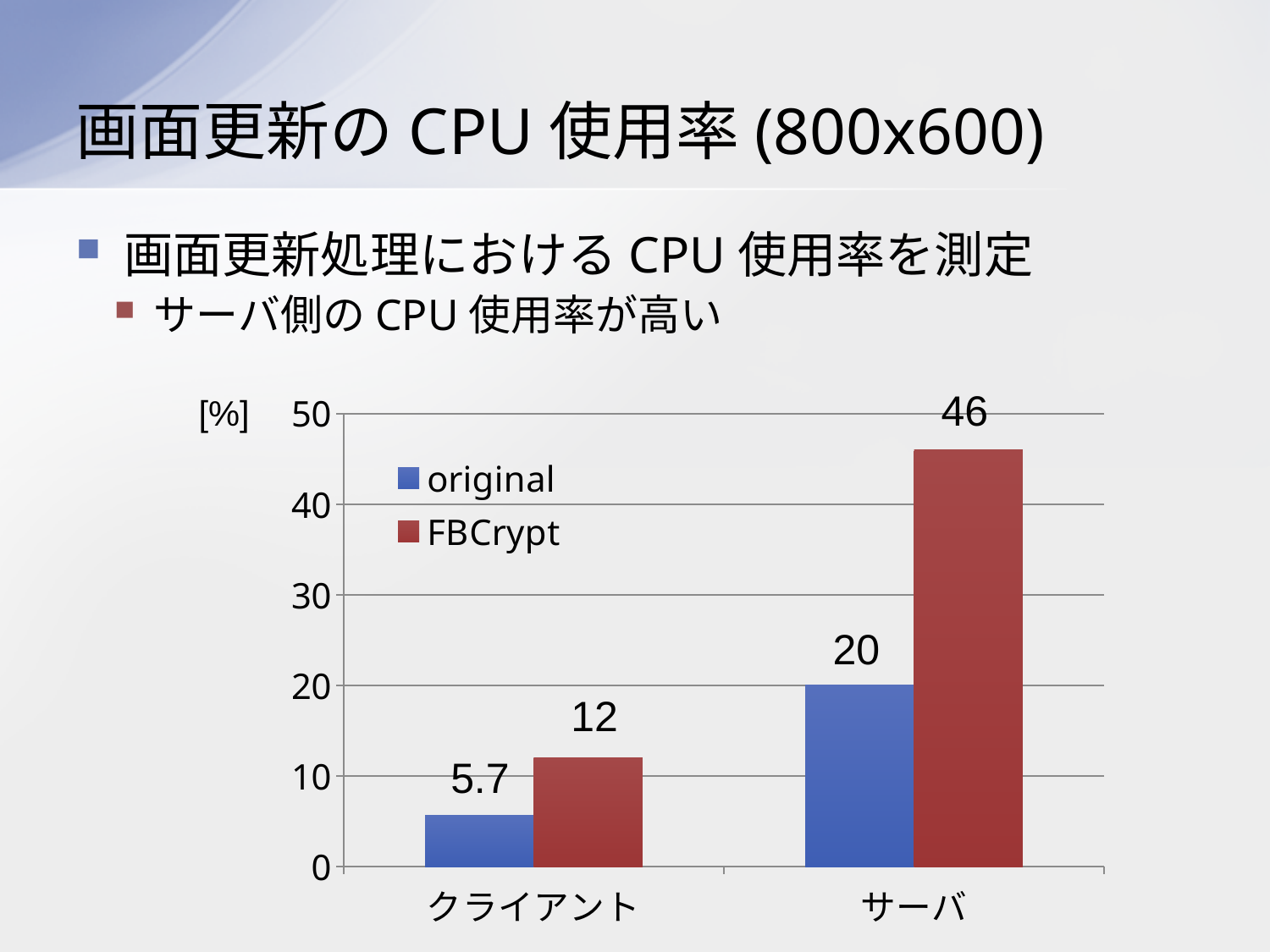
Which category has the highest FBCrypt value? サーバ What is the CPU usage value for FBCrypt on サーバ? 46 What is the CPU usage value for original on クライアント? 5.7 Which is larger on クライアント: the original value or the FBCrypt value? FBCrypt How many categories are shown on the x axis? 2 What is the difference between the FBCrypt and original values on サーバ? 26 How many series does the legend list? 2 What kind of chart is shown on the slide? bar chart What is the CPU usage value for FBCrypt on クライアント? 12 Which category has the lowest original value? クライアント Is the FBCrypt value for サーバ greater or less than 40? greater What is the CPU usage value for original on サーバ? 20